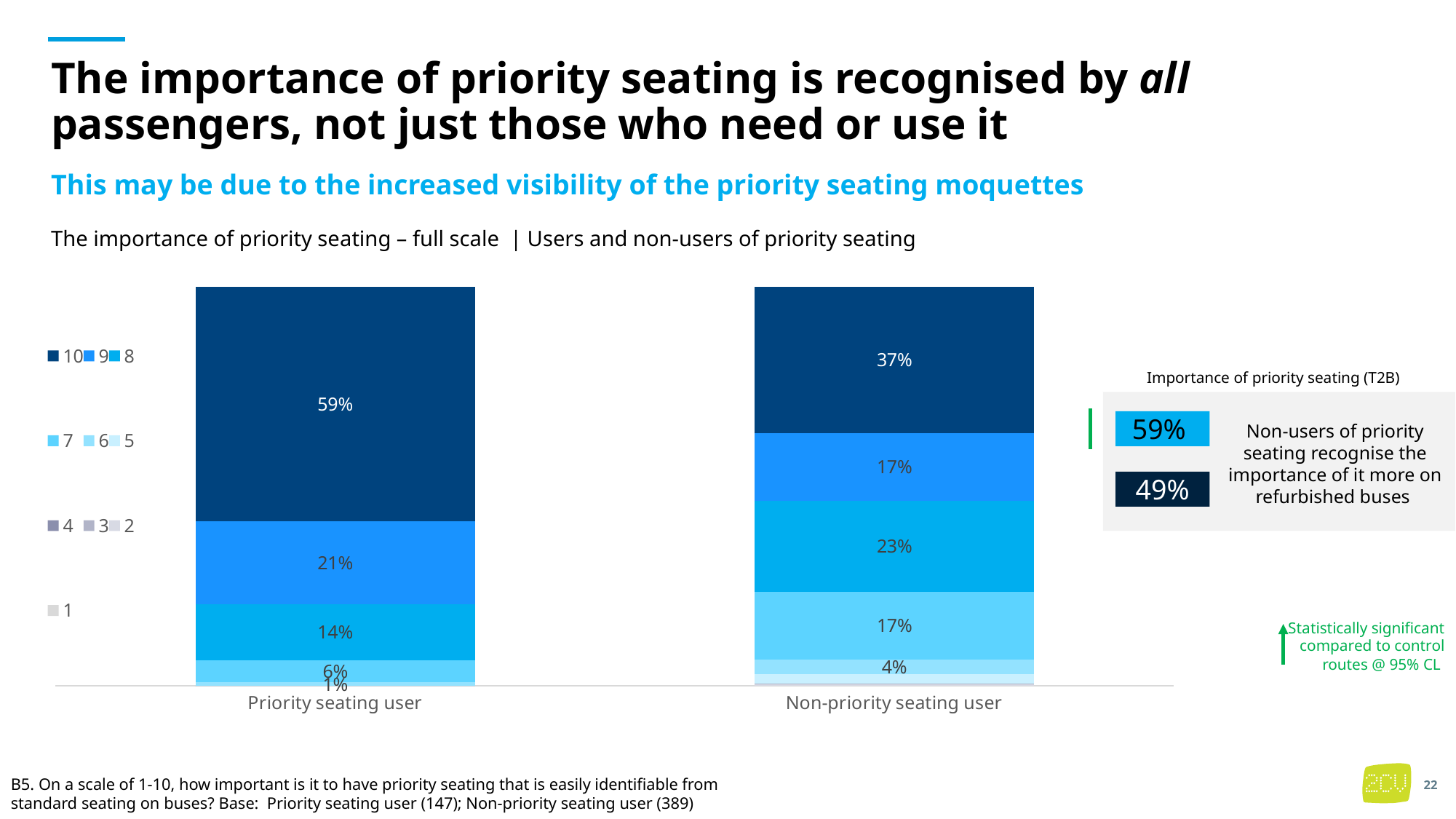
What is the title of the chart on the slide? The importance of priority seating – full scale | Users and non-users of priority seating What percentage of non-priority seating users gave a rating of 8? 23% What percentage of non-priority seating users rated the importance of priority seating as 10? 37% Which rating segment is the largest for non-priority seating users? 10 How many categories are shown on the x axis of the chart? 2 What kind of chart is shown on the slide? Stacked bar chart What percentage of priority seating users gave a rating of 9? 21% What is the difference between the share of priority seating users and non-priority seating users who gave a rating of 10? 22 percentage points What percentage of non-priority seating users gave a rating of 7? 17% What percentage of priority seating users rated the importance of priority seating as 10? 59% How many series does the chart legend list? 10 Which category has the larger share of respondents rating 10: Priority seating user or Non-priority seating user? Priority seating user